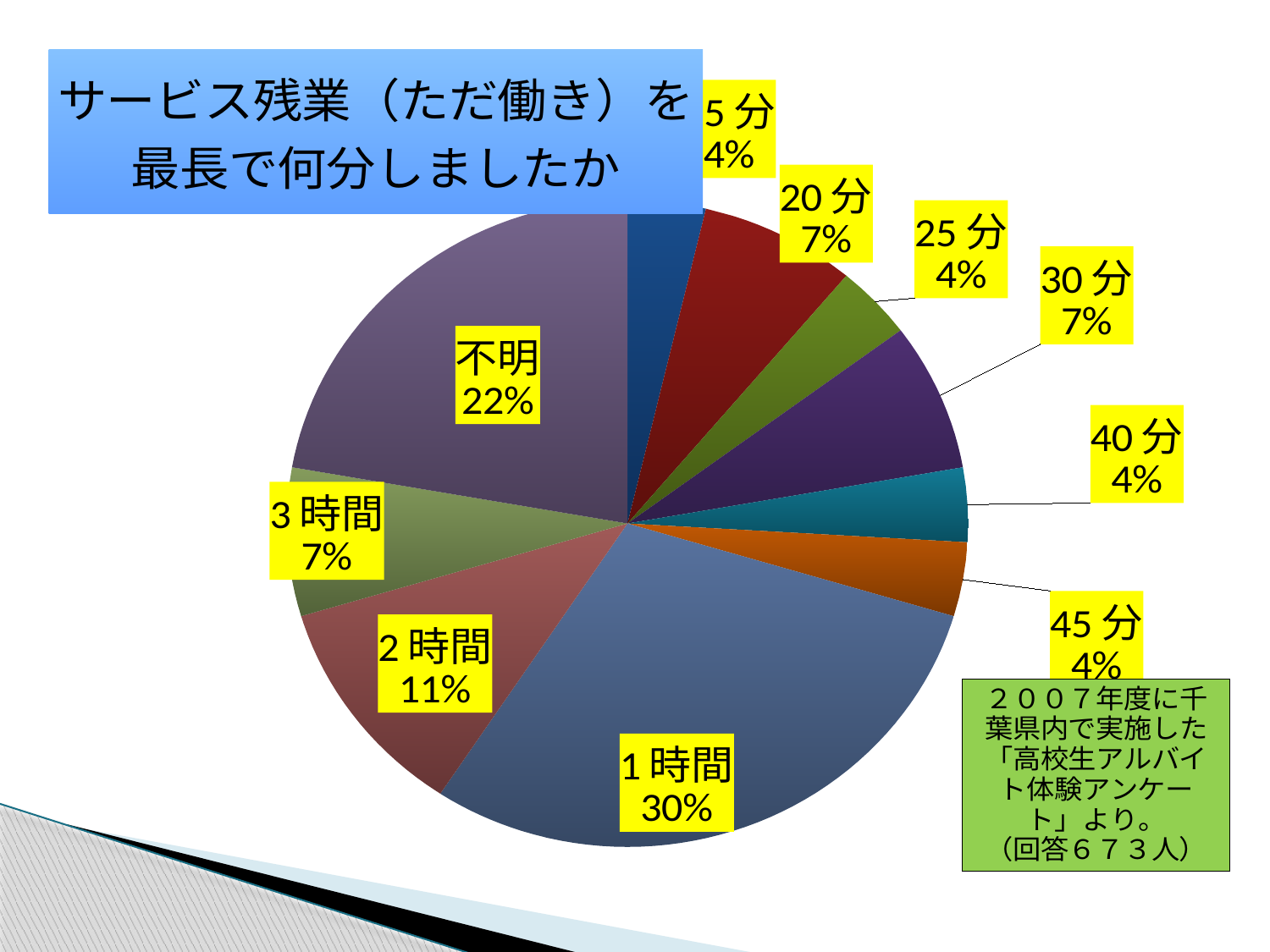
What is the difference in percentage points between 30分 and 25分? 3 What share of the pie does 1時間 represent? 30% What is the title of the chart? サービス残業（ただ働き）を最長で何分しましたか Which is larger, the share for 2時間 or the share for 3時間? 2時間 What kind of chart is shown on the slide? pie chart What is the difference in percentage points between 1時間 and 不明? 8 What share of the pie does 20分 represent? 7% What share of the pie does 不明 represent? 22% Which category has the largest slice of the pie? 1時間 How many slices does the pie chart have? 10 What share of the pie does 2時間 represent? 11% What share of the pie does 40分 represent? 4%